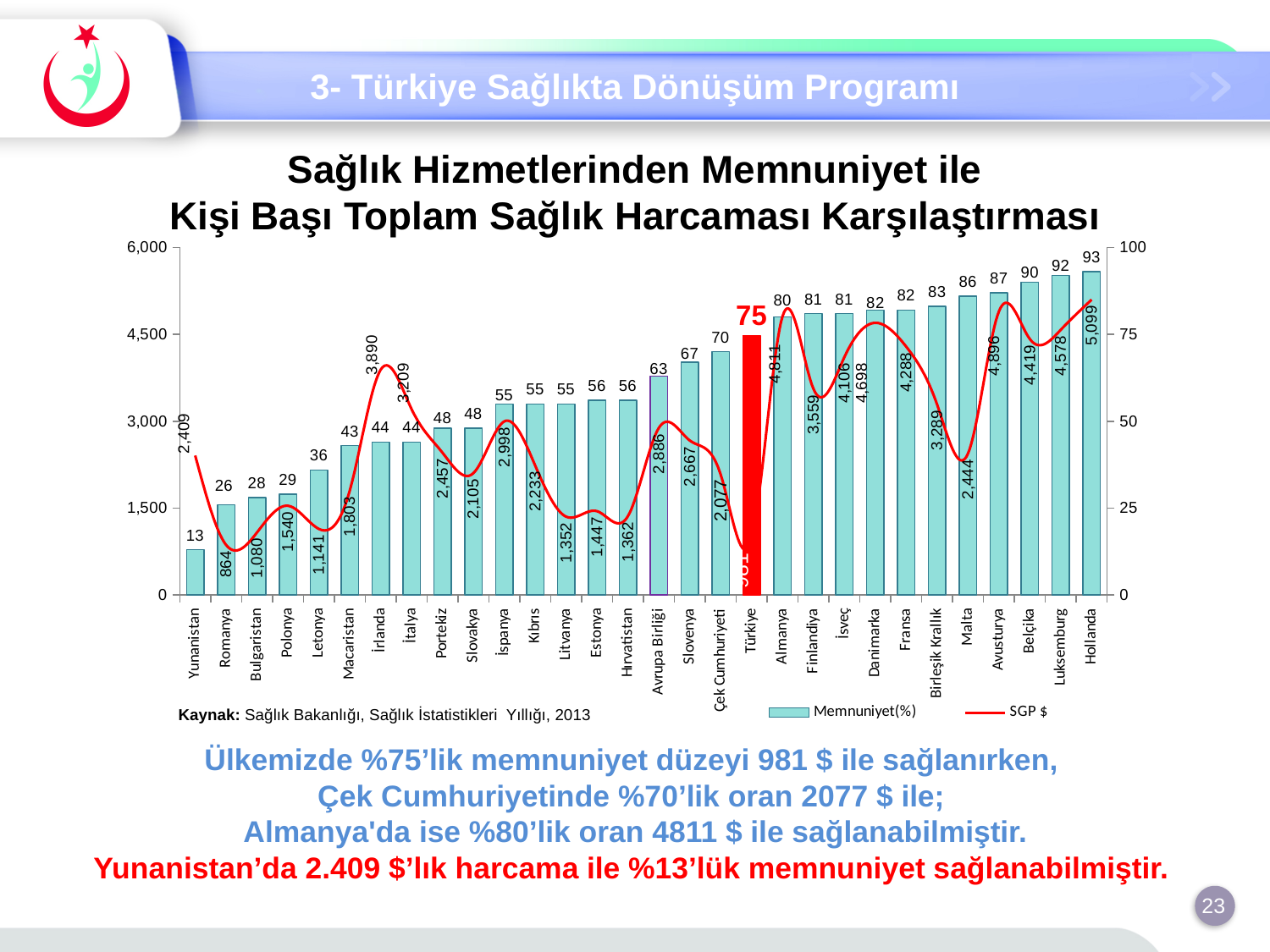
Which has a higher Memnuniyet(%) value, Almanya or Çek Cumhuriyeti? Almanya How many countries/categories are shown on the x axis? 30 What is the difference in Memnuniyet(%) between Hollanda and Yunanistan? 80 Do the Memnuniyet(%) bars rise or fall from left to right along the x axis? rise What is the Memnuniyet(%) value for Türkiye? 75 Which country has the highest SGP $ value? Hollanda Which country has the highest Memnuniyet(%) value? Hollanda What is the Memnuniyet(%) value for Avrupa Birliği? 63 What is the SGP $ value for Romanya? 864 What is the SGP $ value for Hollanda? 5,099 Which country has the lowest Memnuniyet(%) value? Yunanistan How many series does the legend list? 2